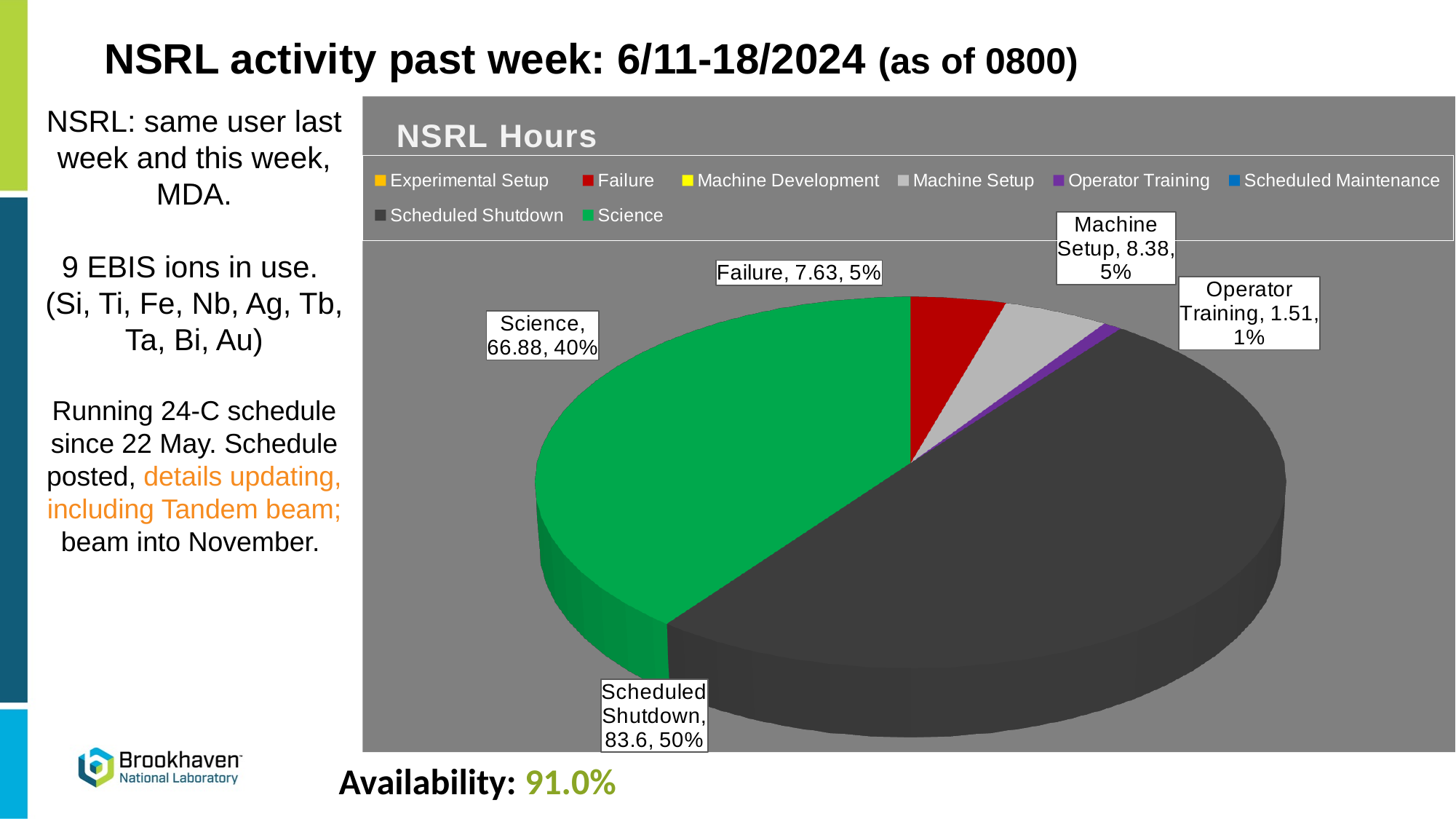
Which category has the largest slice of the pie? Scheduled Shutdown How many entries does the chart legend list? 8 What is the title of the chart? NSRL Hours What kind of chart is shown on the slide? pie chart What share of the pie does Machine Setup account for? 5% Which labelled category has the smallest slice of the pie? Operator Training How many hours does the Failure slice represent? 7.63 What is the difference in hours between Scheduled Shutdown and Science? 16.72 What share of the pie does Operator Training account for? 1% Which is larger in hours, Machine Setup or Failure? Machine Setup How many hours does the Science slice represent? 66.88 How many hours does the Scheduled Shutdown slice represent? 83.6